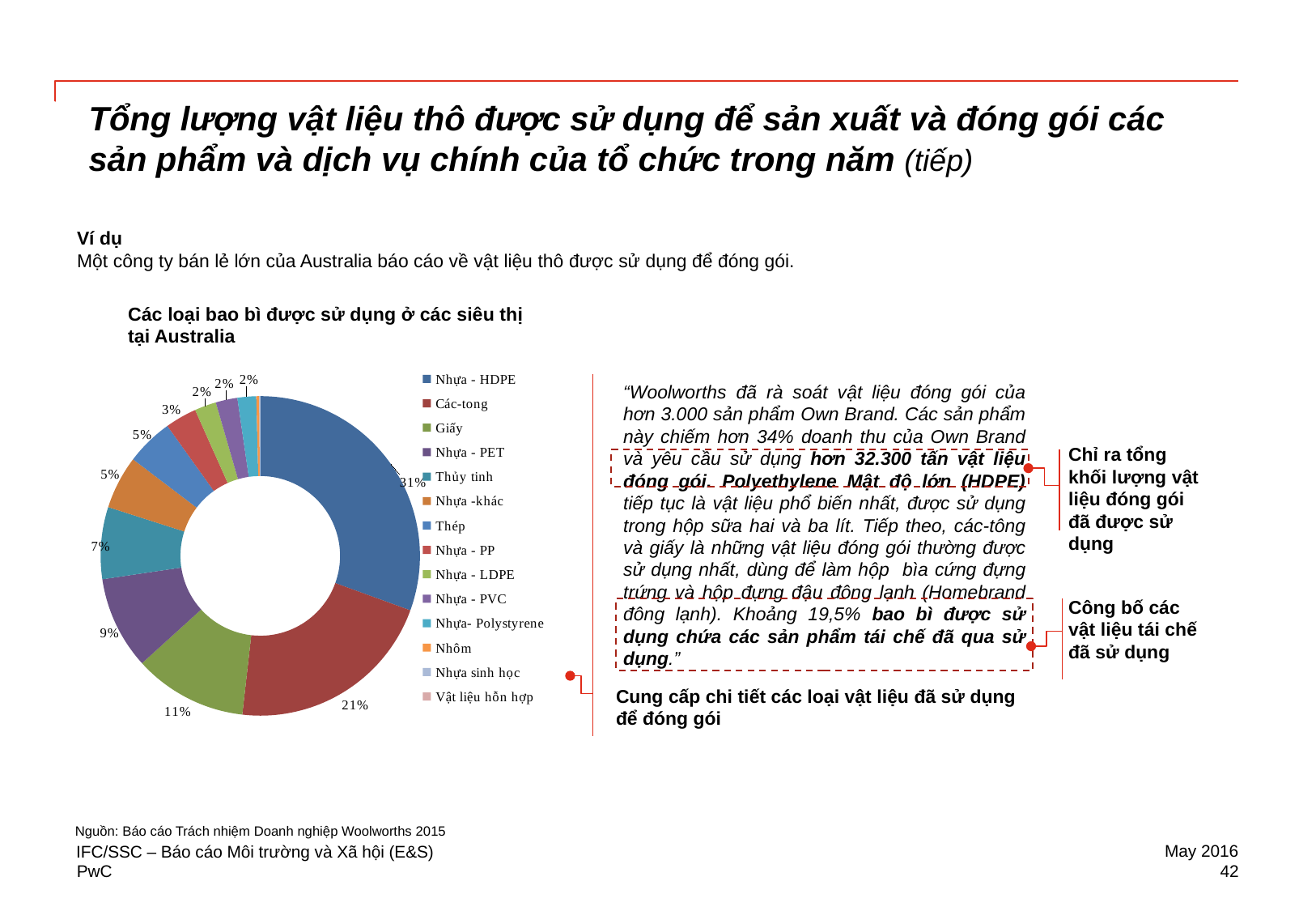
What share of the chart does Nhựa - HDPE account for? 31% What share of the chart does Nhựa - PET account for? 9% What share of the chart does Nhựa - PP account for? 3% What is the title of the chart? Các loại bao bì được sử dụng ở các siêu thị tại Australia What is the difference in percentage points between the shares of Nhựa - HDPE and Các-tong? 10 percentage points Which has a larger share, Giấy or Nhựa - PET? Giấy How many categories does the chart legend list? 14 Which packaging material has the largest share in the chart? Nhựa - HDPE What kind of chart is shown on the slide? Pie chart (donut)